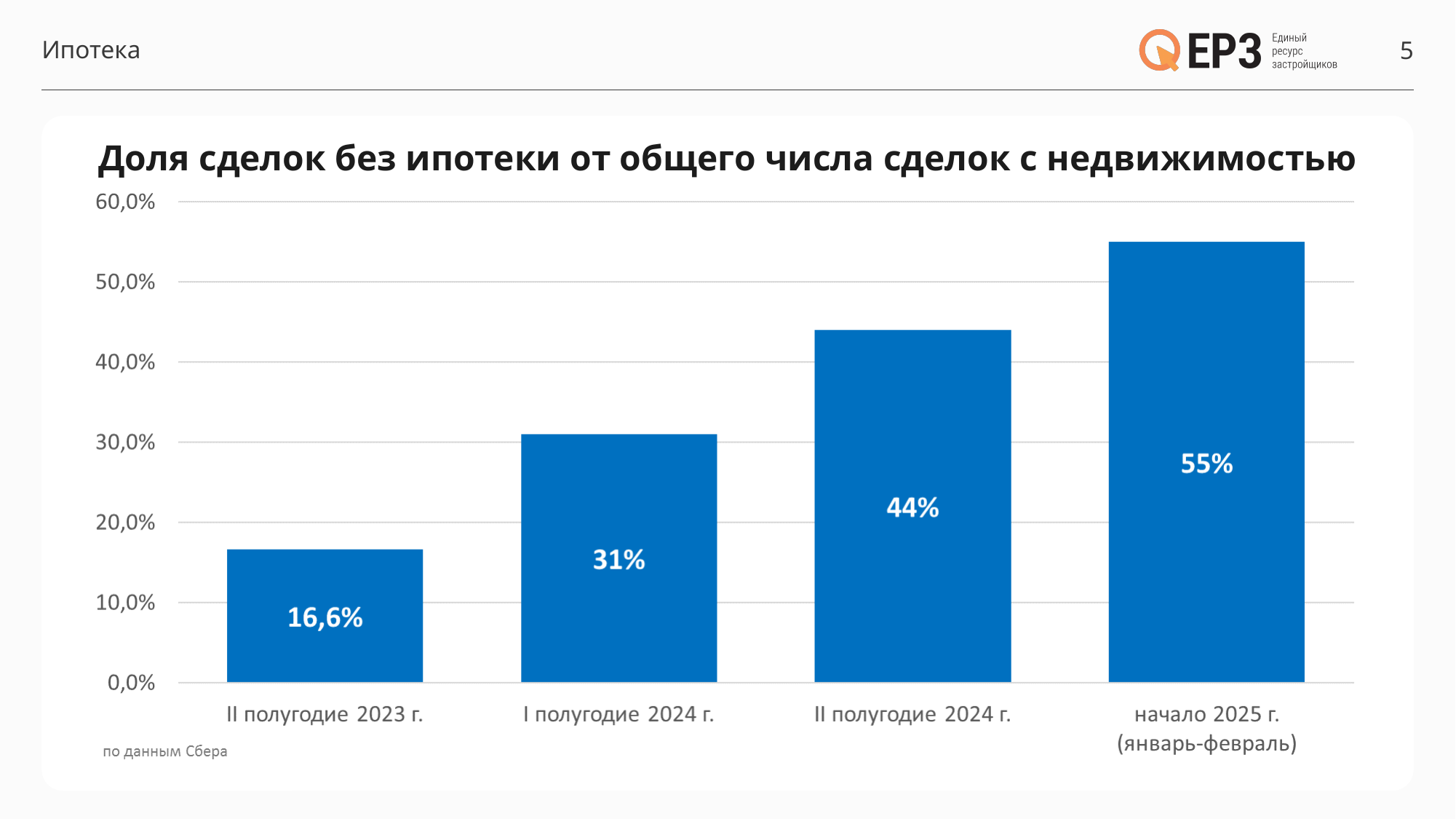
How many categories are shown on the x axis? 4 Do the values rise or fall from left to right along the x axis? rise Which is larger: the value for I полугодие 2024 г. or II полугодие 2024 г.? II полугодие 2024 г. Which category has the highest value? начало 2025 г. (январь-февраль) What is the value for I полугодие 2024 г.? 31% What is the value for начало 2025 г. (январь-февраль)? 55% What is the value for II полугодие 2024 г.? 44% Is the value for I полугодие 2024 г. greater or less than 40,0%? less What is the difference between the values for начало 2025 г. (январь-февраль) and II полугодие 2024 г.? 11% What is the value for II полугодие 2023 г.? 16,6% Which category has the lowest value? II полугодие 2023 г. What kind of chart is shown on the slide? bar chart